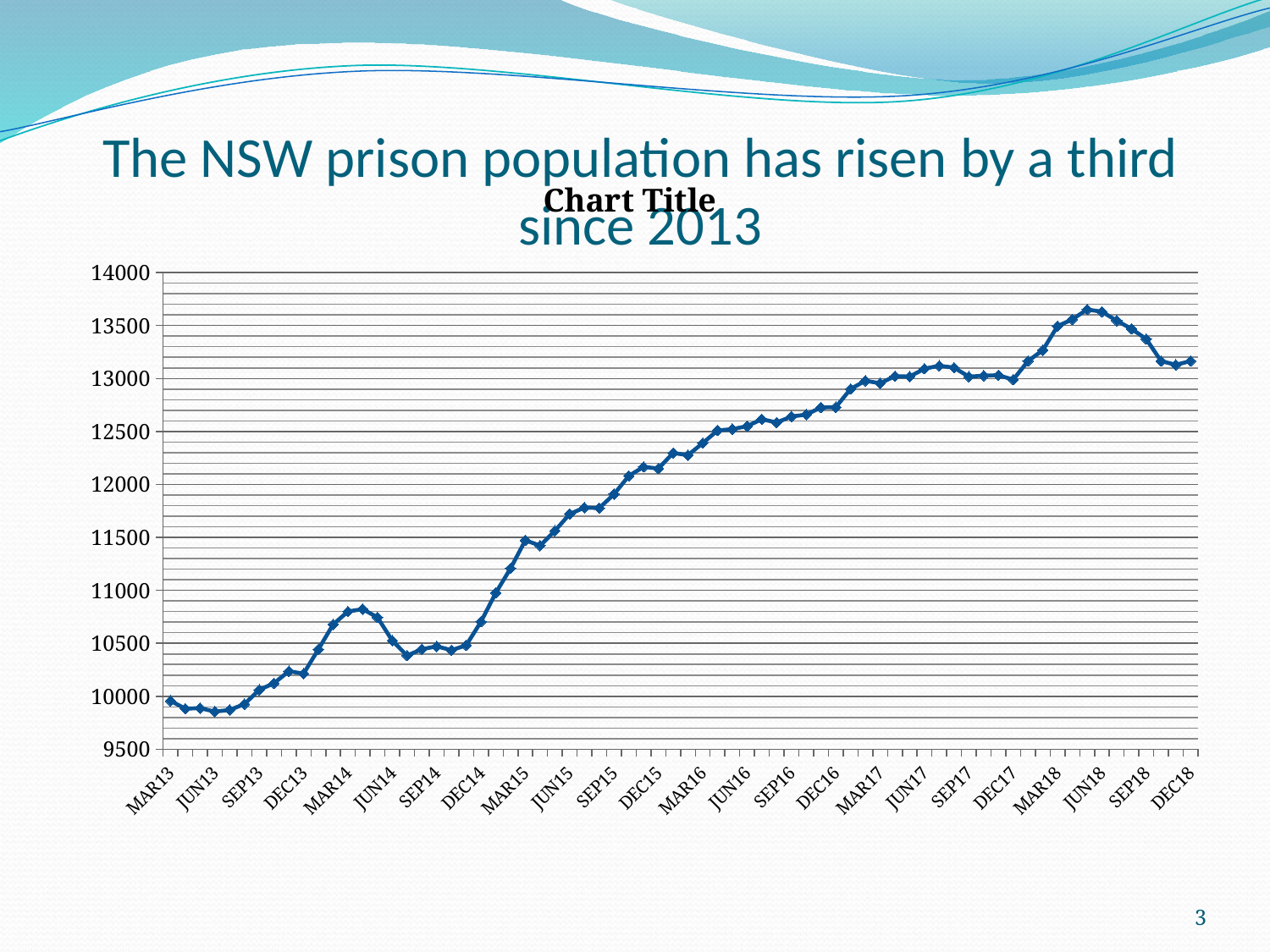
Overall, does the line rise or fall from MAR13 to DEC18? rise How many date labels are shown on the x axis? 24 Is the value for SEP16 greater or less than 12500? greater Is the value for MAR15 greater or less than 11000? greater Is the value for JUN13 greater or less than 10000? less What kind of chart is shown on the slide? line chart What is the title printed above the chart? Chart Title Does the line rise or fall between JUN18 and SEP18? fall